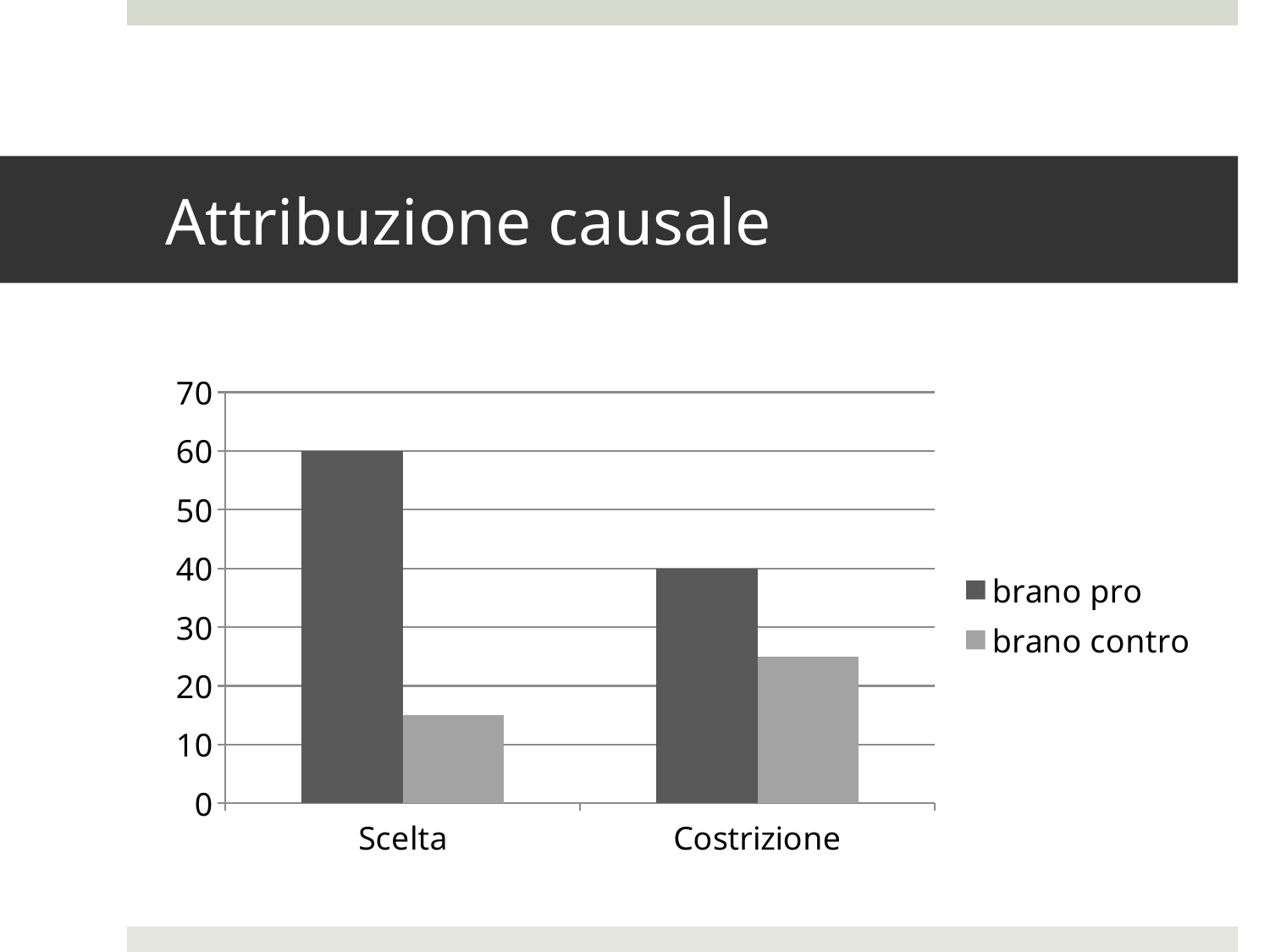
What type of chart is shown on the slide? bar chart Is the value of brano contro for Costrizione greater or less than 30? less What is the difference between the brano pro values for Scelta and Costrizione? 20 What is the value of brano pro for Scelta? 60 Which category has the higher brano pro value, Scelta or Costrizione? Scelta Which bar is the tallest in the chart? brano pro for Scelta Is the value of brano contro for Scelta greater or less than 20? less How many series does the legend list? 2 Which category has the higher brano contro value, Scelta or Costrizione? Costrizione Which bar is the shortest in the chart? brano contro for Scelta Is the value of brano contro for Costrizione greater or less than 20? greater What is the value of brano pro for Costrizione? 40